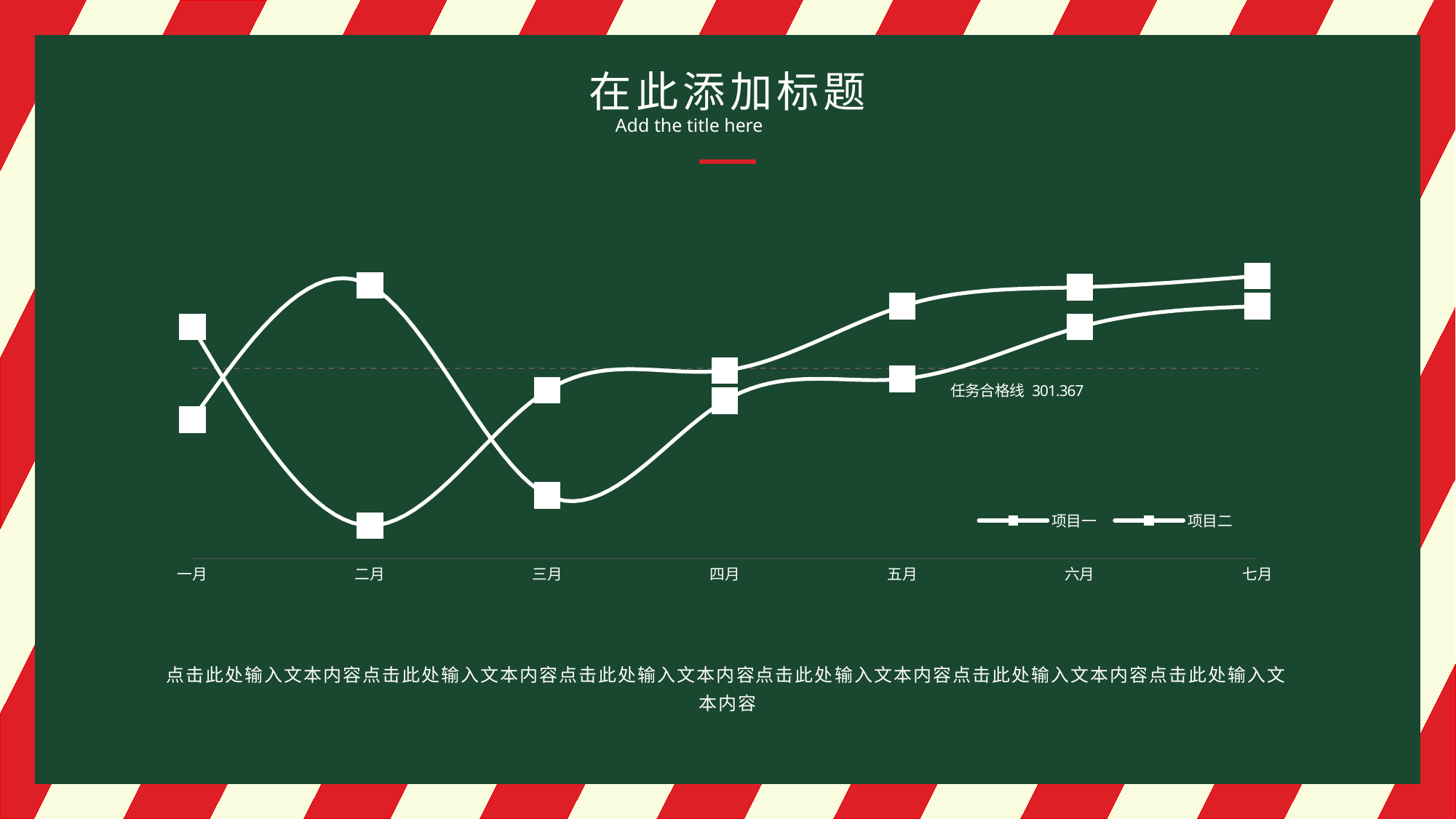
Which month is the first category on the x axis of the chart? 一月 How many months are shown along the x axis of the chart? 7 In 六月, are the values of both series greater or less than the 任务合格线 of 301.367? greater From 四月 to 七月, do the values of both series rise or fall? rise What value is printed next to the dashed reference line labelled 任务合格线? 301.367 In 三月, are the values of both series greater or less than the 任务合格线 of 301.367? less In 七月, are the values of both series greater or less than the 任务合格线 of 301.367? greater What kind of chart is shown on the slide? line chart What are the two series names listed in the chart's legend? 项目一 and 项目二 How many series does the chart's legend list? 2 Which month is the last category on the x axis of the chart? 七月